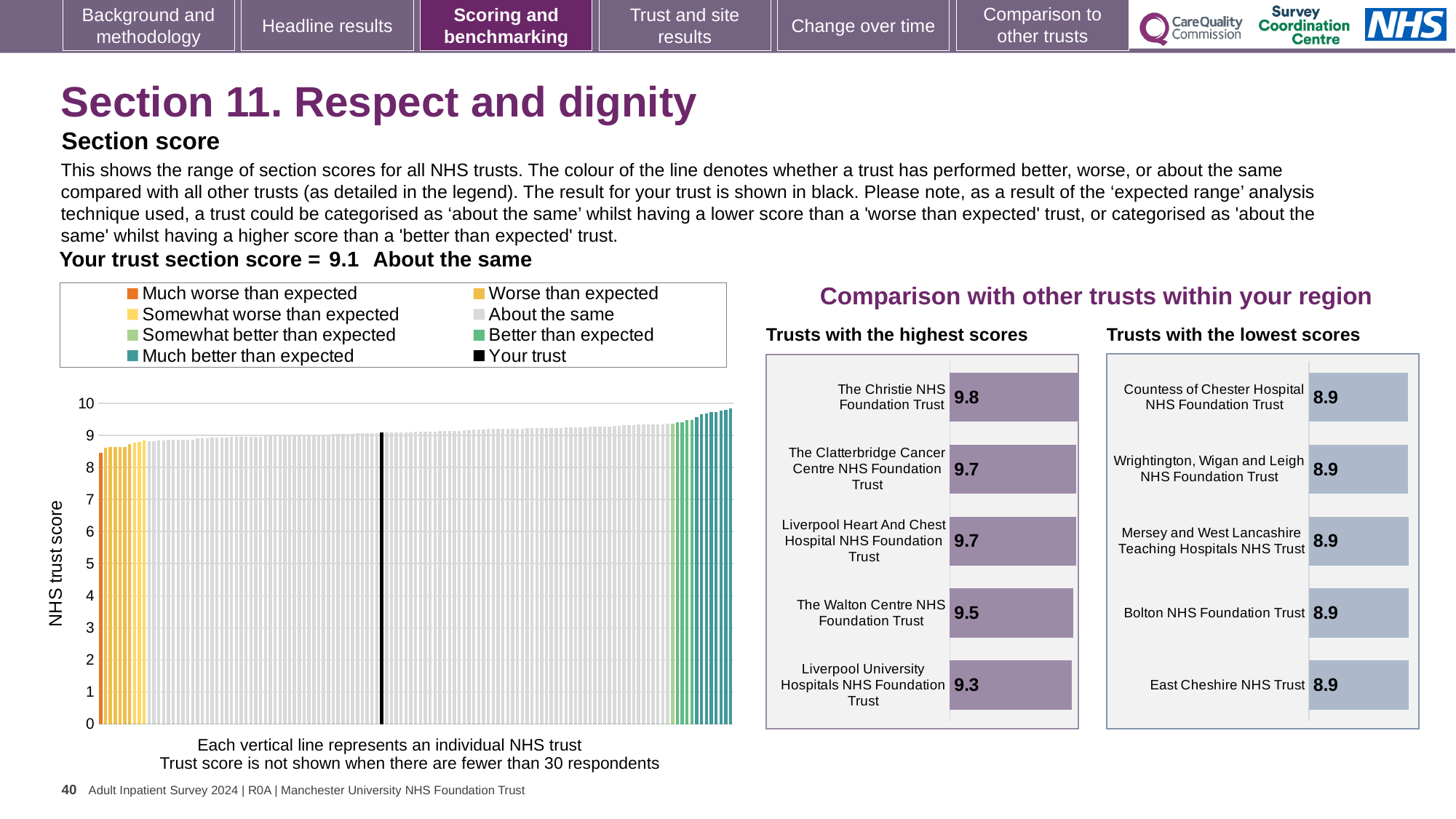
In the 'Trusts with the highest scores' chart, which trust has the highest score? The Christie NHS Foundation Trust In the 'Trusts with the lowest scores' chart, what is the score for Bolton NHS Foundation Trust? 8.9 In the 'Trusts with the highest scores' chart, what is the difference between the scores of The Christie NHS Foundation Trust and Liverpool University Hospitals NHS Foundation Trust? 0.5 In the main chart on the left, what is the label of the vertical axis? NHS trust score In the 'Trusts with the highest scores' chart, how many trusts are shown? 5 In the main chart on the left, do the trust scores rise or fall from left to right? rise In the main chart on the left, how many entries does the legend list? 8 In the main chart of NHS trust scores on the left, what is the section score for your trust? 9.1 In the main chart on the left, is the value of the leftmost (lowest) bar greater or less than 9? less In the 'Trusts with the highest scores' chart, which is larger: the score for The Clatterbridge Cancer Centre NHS Foundation Trust or the score for The Walton Centre NHS Foundation Trust? The Clatterbridge Cancer Centre NHS Foundation Trust What kind of chart is the main chart on the left showing the range of section scores? bar chart In the 'Trusts with the highest scores' chart, what is the score for The Walton Centre NHS Foundation Trust? 9.5